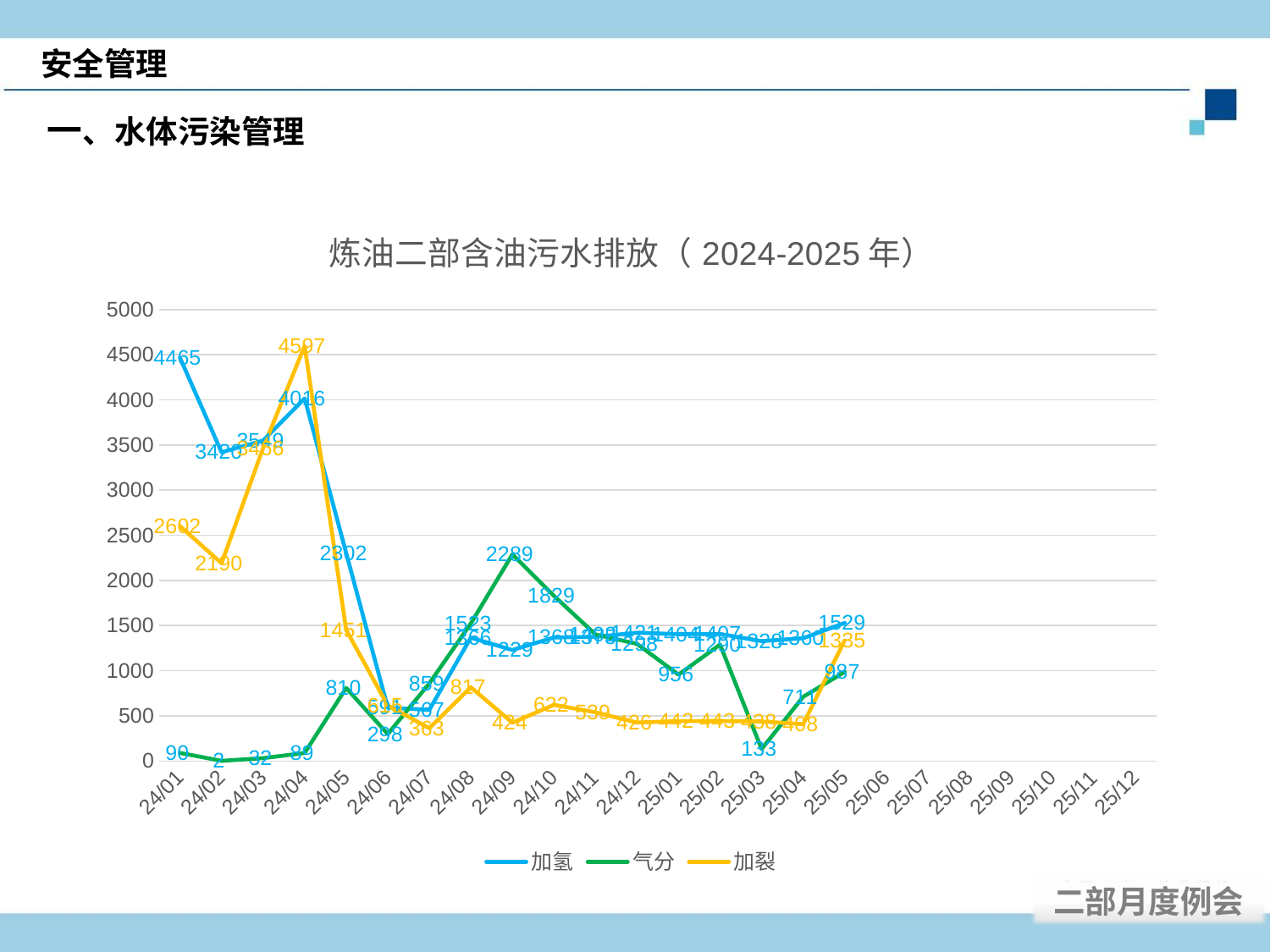
How many series does the legend list? 3 What is the value for 气分 in 25/03? 133 Does the 加氢 line rise or fall from 24/04 to 24/06? fall In which month does 加裂 reach its highest value? 24/04 What kind of chart is shown on the slide? line chart What is the value for 加裂 in 24/01? 2602 In 24/05, which is larger, 加氢 or 加裂? 加氢 What is the value for 气分 in 24/09? 2289 How many months are labelled on the x axis? 24 What is the value for 加氢 in 24/01? 4465 What is the difference between the 加氢 values in 24/01 and 24/04? 449 What is the value for 加裂 in 24/04? 4597